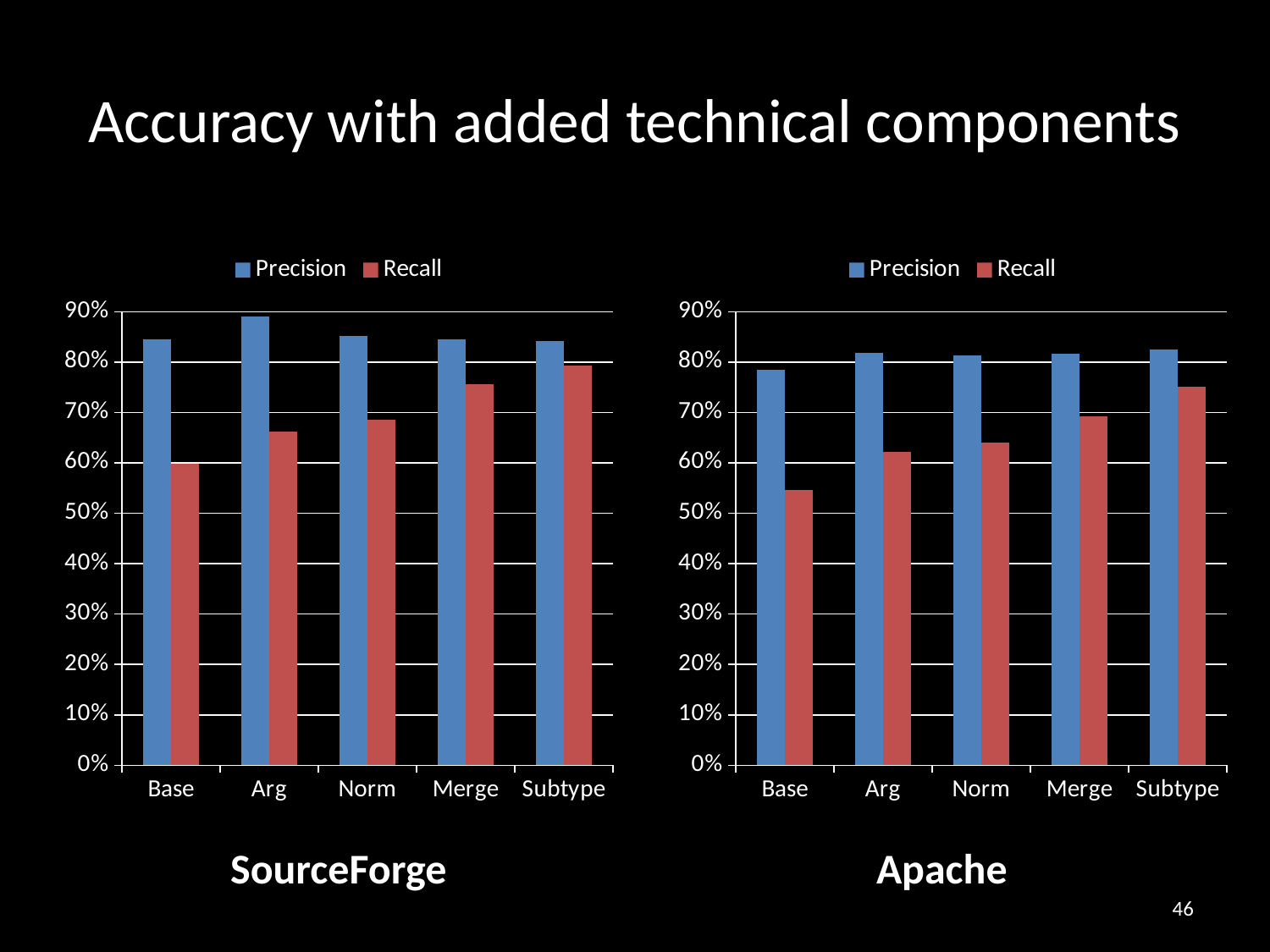
In the Apache chart, does Recall rise or fall from Base to Subtype? rise In the SourceForge chart, which category has the lowest Recall? Base In the Apache chart, is the Recall value for Subtype greater or less than 70%? greater In the Apache chart, which category has the lowest Precision? Base How many series does the legend of the Apache chart list? 2 In the SourceForge chart, is the Precision value for Arg greater or less than 80%? greater In the SourceForge chart, which is larger for Merge: Precision or Recall? Precision What kind of chart is the SourceForge chart? bar chart In the Apache chart, is the Precision value for Base greater or less than 80%? less How many categories are shown on the x axis of the SourceForge chart? 5 In the SourceForge chart, which category has the highest Precision? Arg In the Apache chart, which category has the highest Recall? Subtype